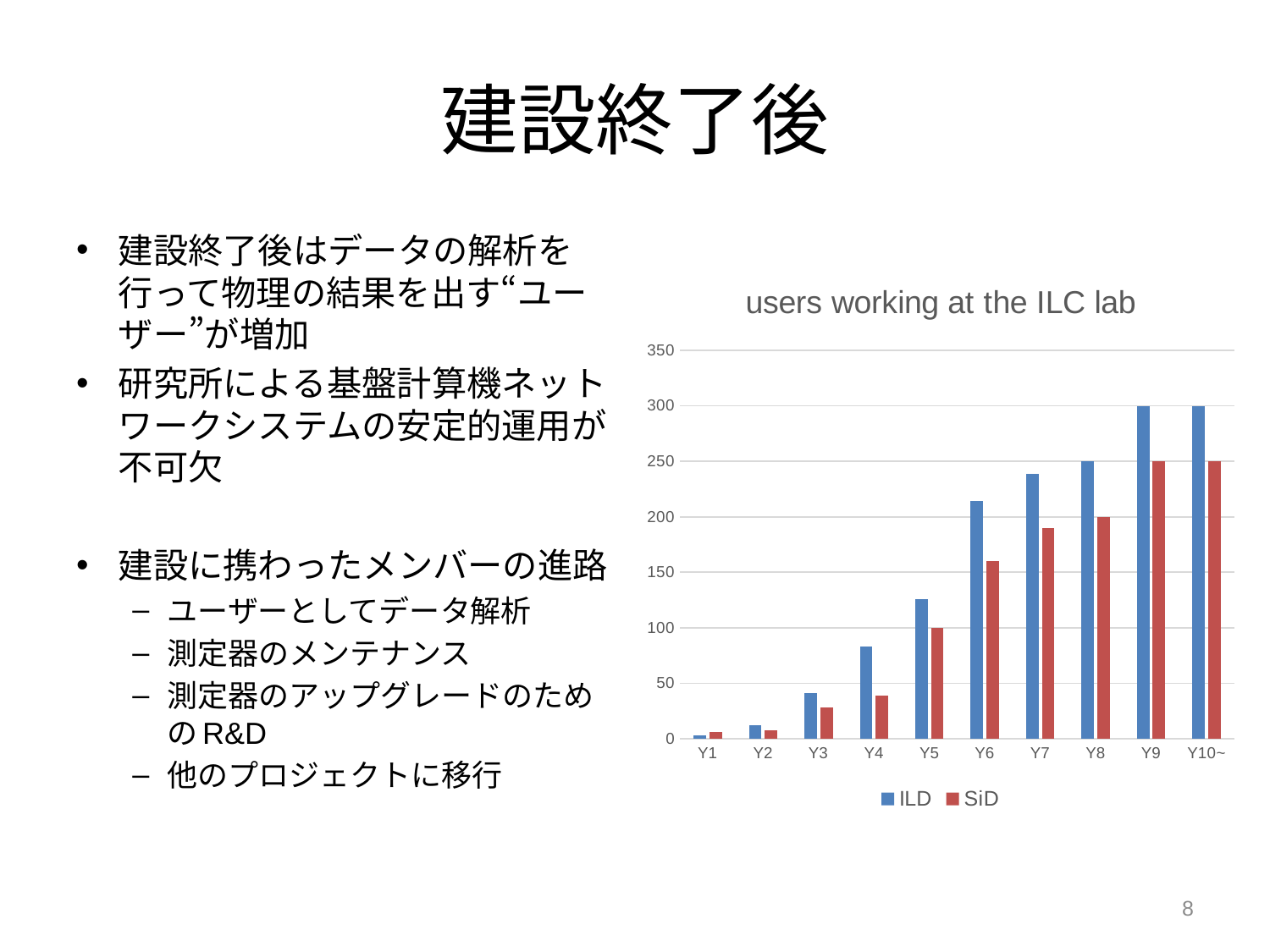
What is the title of the chart? users working at the ILC lab Do the ILD values generally rise or fall from Y1 to Y9? rise How many categories are shown on the x axis of the chart? 10 What is the SiD value for Y5? 100 What is the ILD value for Y9? 300 What is the SiD value for Y9? 250 Is the SiD value for Y4 greater or less than 50? less How many series does the chart legend list? 2 Which is larger at Y7, the ILD value or the SiD value? ILD Which category has the lowest ILD value? Y1 What kind of chart is shown on the slide? bar chart Is the ILD value for Y6 greater or less than 200? greater